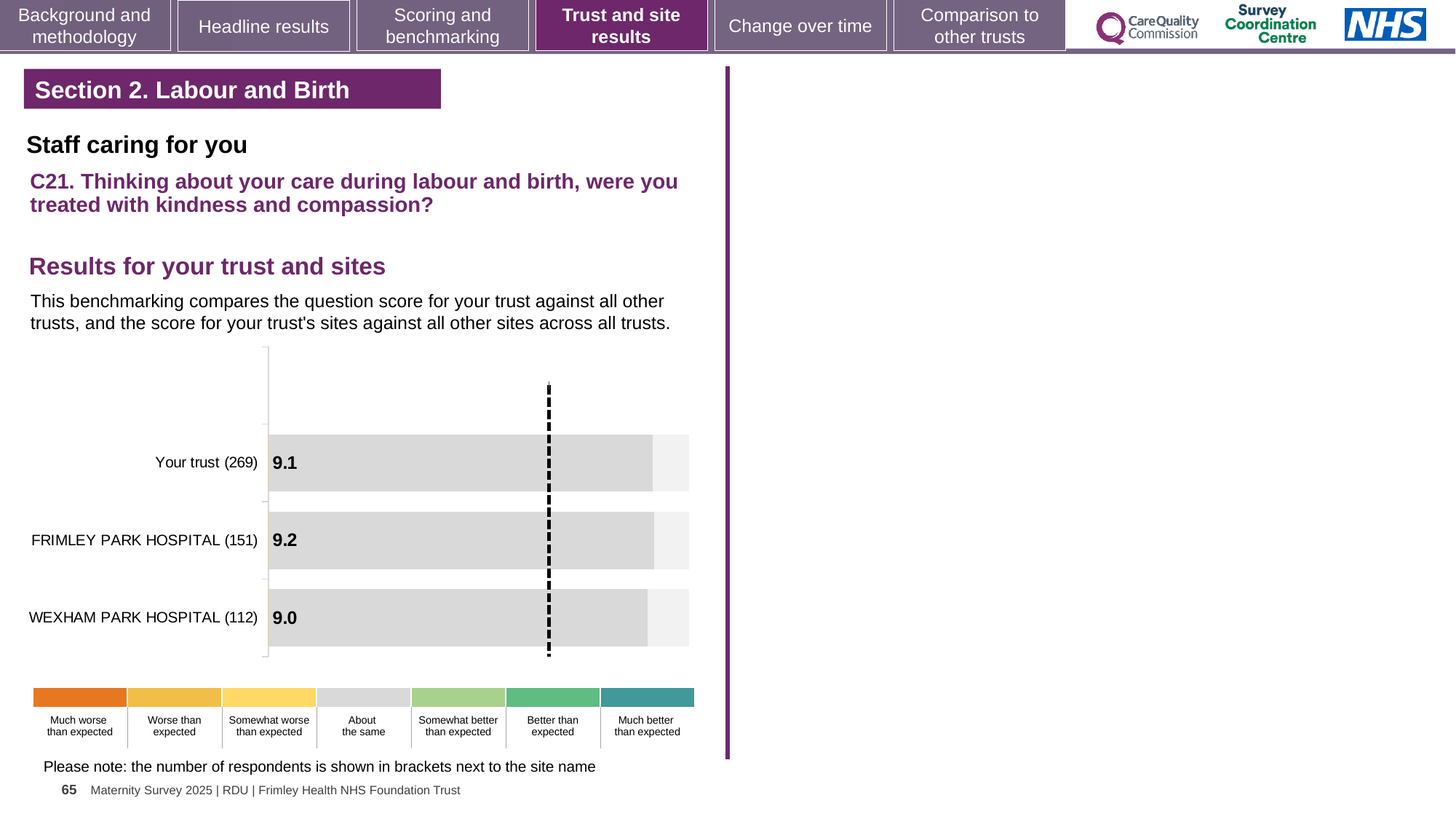
Which site or trust has the lowest score? WEXHAM PARK HOSPITAL How many bars are shown in the chart? 3 What is the score for FRIMLEY PARK HOSPITAL? 9.2 What is the score for WEXHAM PARK HOSPITAL? 9.0 Which site or trust has the highest score? FRIMLEY PARK HOSPITAL What is the difference between the scores for FRIMLEY PARK HOSPITAL and WEXHAM PARK HOSPITAL? 0.2 Which has the larger score, Your trust or FRIMLEY PARK HOSPITAL? FRIMLEY PARK HOSPITAL How many respondents are shown in brackets for WEXHAM PARK HOSPITAL? 112 What kind of chart is shown on the slide? Bar chart How many respondents are shown in brackets for Your trust? 269 What is the difference between the scores for Your trust and WEXHAM PARK HOSPITAL? 0.1 What is the score for Your trust? 9.1